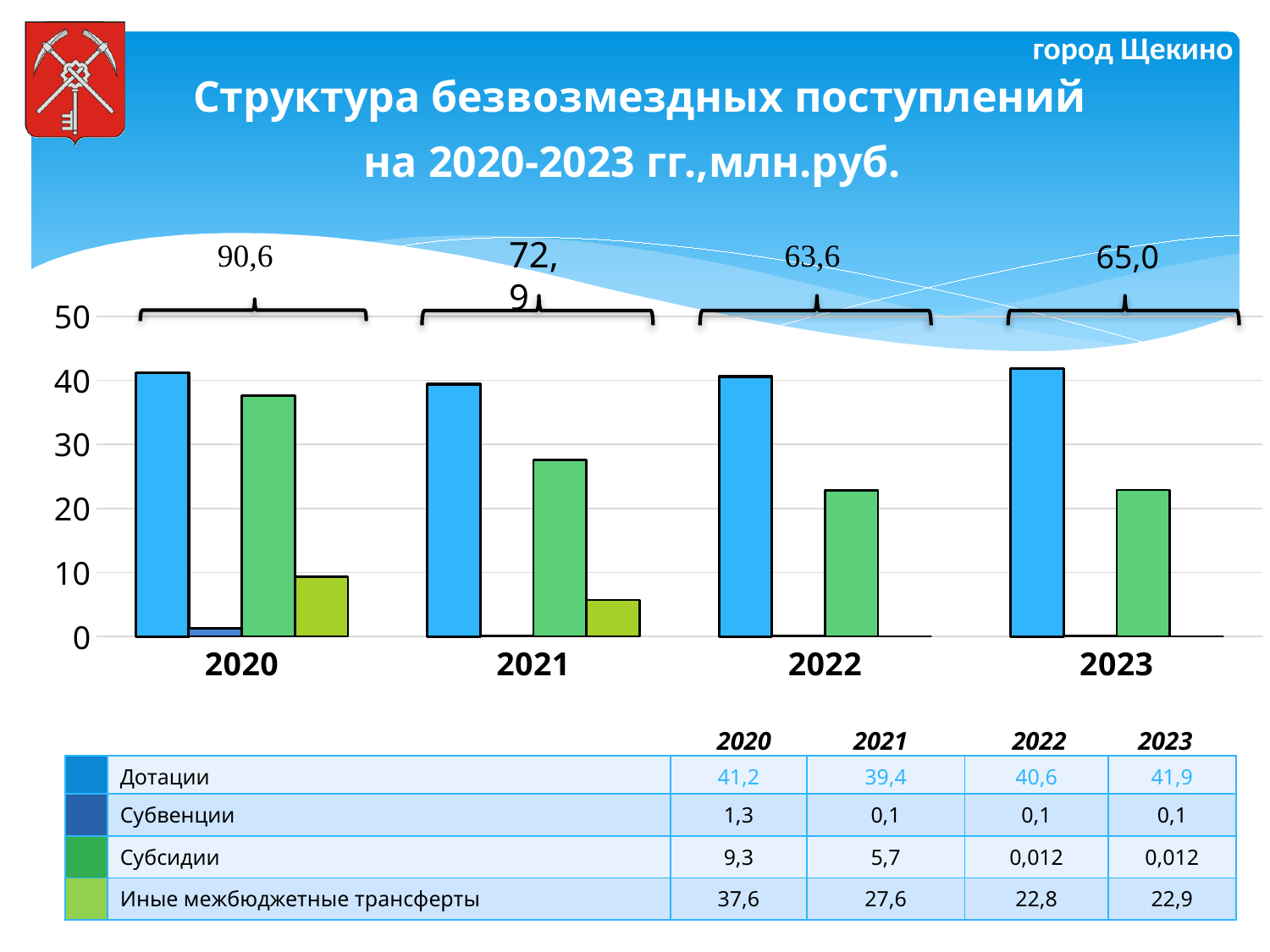
Is the value for Иные межбюджетные трансферты in 2022 greater or less than 20? greater What is the value for Иные межбюджетные трансферты in 2021? 27,6 What is the value for Дотации in 2020? 41,2 What is the value for Субвенции in 2020? 1,3 In which year is the value for Дотации the highest? 2023 In 2020, which is larger: Дотации or Иные межбюджетные трансферты? Дотации How many years are shown on the x axis of the chart? 4 What kind of chart is shown on the slide? bar chart What is the difference between the Дотации values for 2023 and 2021? 2,5 What is the total of all receipts shown above the bracket for 2020? 90,6 In which year is the value for Дотации the lowest? 2021 What is the value for Субсидии in 2022? 0,012